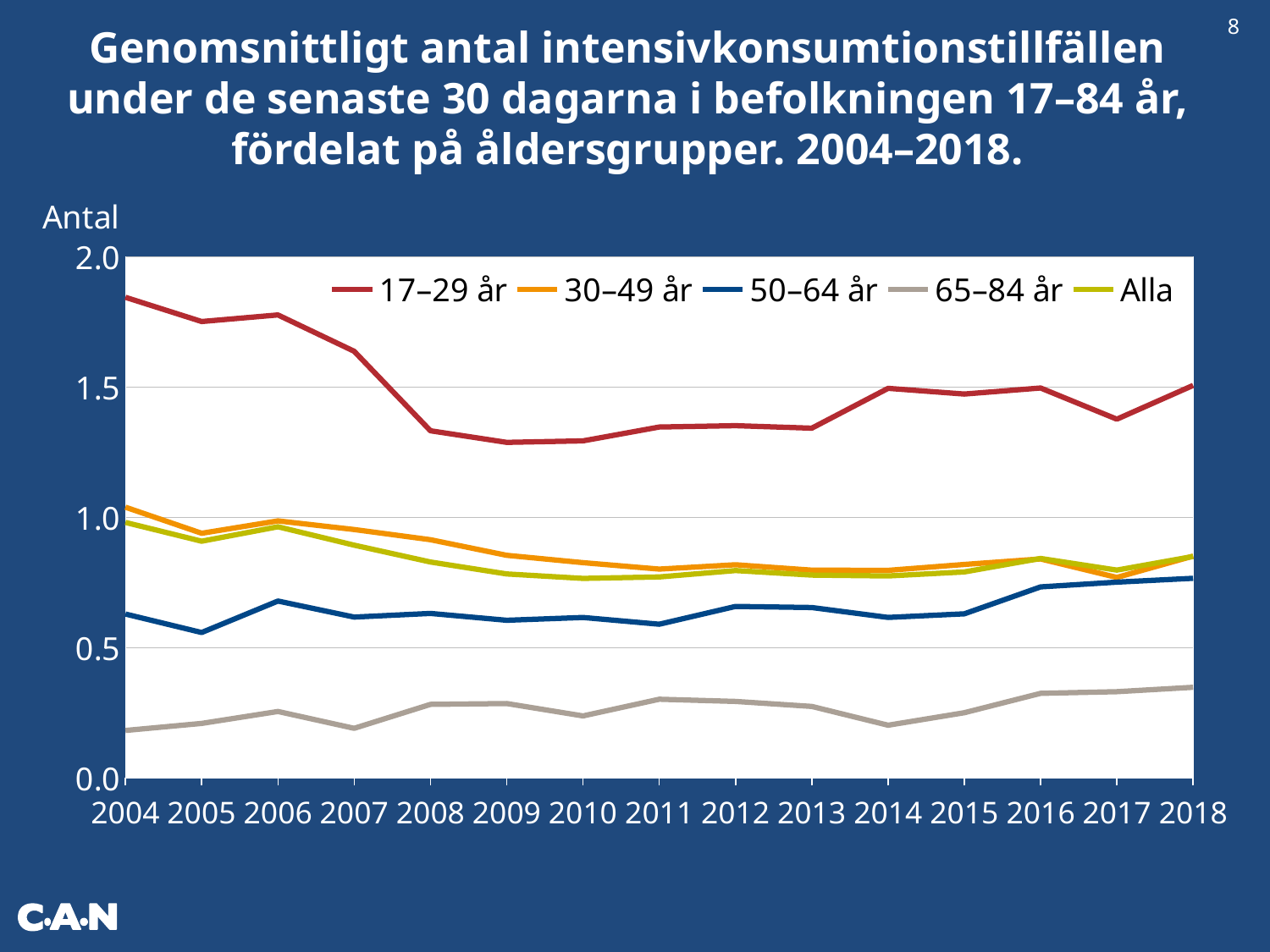
How many series does the legend list? 5 What is the label on the y axis? Antal Which age group has the highest value in 2004? 17–29 år Does the 65–84 år line rise or fall from 2014 to 2018? rise Does the 17–29 år line rise or fall from 2004 to 2009? fall Is the value for 17–29 år in 2004 greater or less than 1.5? greater Which age group has the lowest value in 2018? 65–84 år For 17–29 år, which year has the larger value, 2004 or 2008? 2004 How many years are shown on the x axis? 15 What kind of chart is shown on the slide? line chart Is the value for 17–29 år in 2010 greater or less than 1.5? less Is the value for 65–84 år in 2018 greater or less than 0.5? less